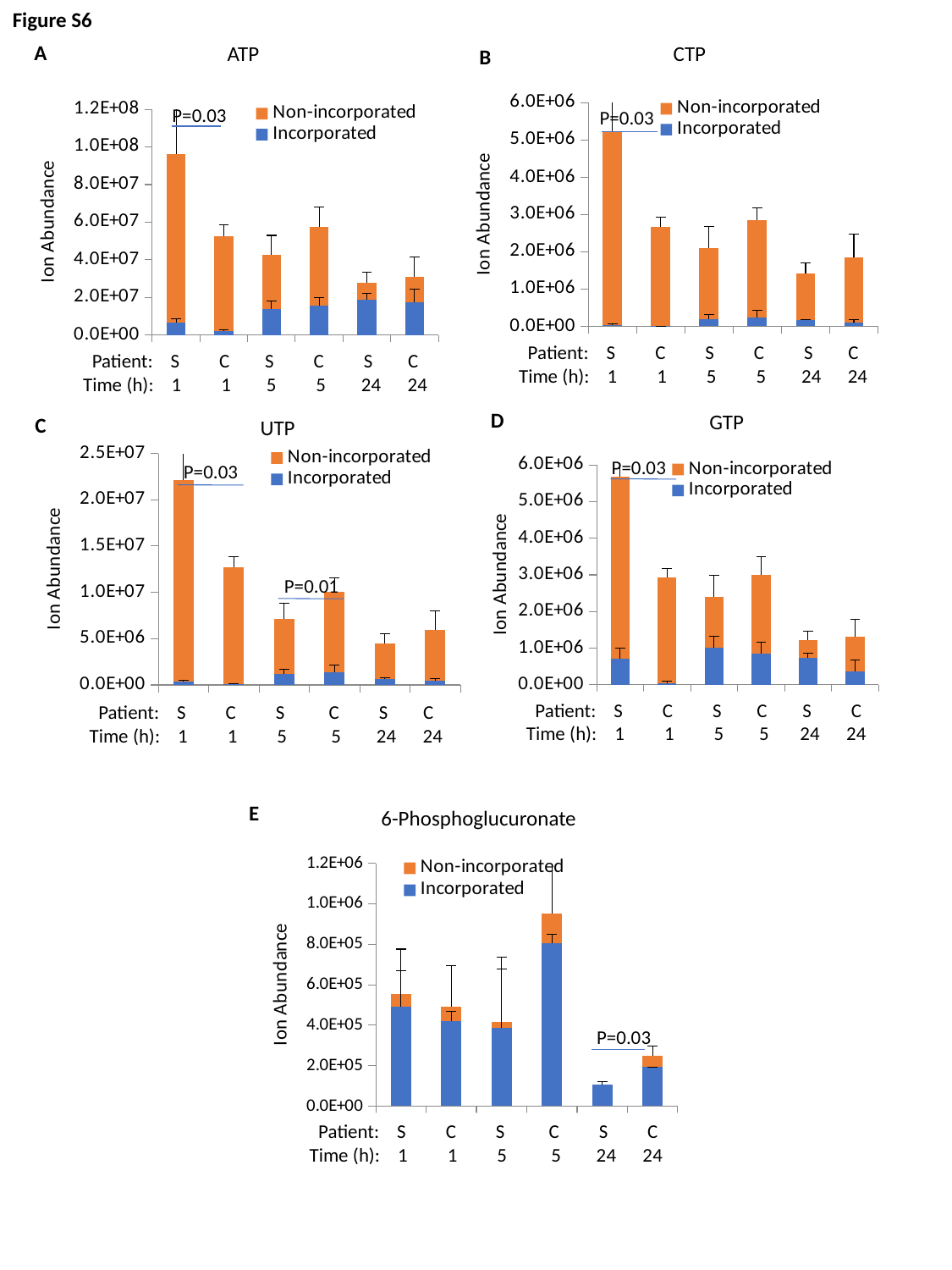
In the CTP chart, is the total value for patient S at 1 h greater or less than 4.0E+06? greater In the UTP chart, is the total value for patient C at 1 h greater or less than 1.0E+07? greater How many series does the legend of the CTP chart list? 2 In the 6-Phosphoglucuronate chart, is the total value for patient C at 5 h greater or less than 8.0E+05? greater In the GTP chart, which patient/time bar has the highest total ion abundance? S at 1 h In the UTP chart, which is larger, the total bar for patient S at 5 h or patient C at 5 h? C at 5 h In the 6-Phosphoglucuronate chart, which patient/time bar has the highest total ion abundance? C at 5 h What type of chart is the 6-Phosphoglucuronate chart? Stacked bar chart In the ATP chart, which patient/time bar has the highest total ion abundance? S at 1 h How many bars are plotted in the ATP chart? 6 In the CTP chart, which patient/time bar has the lowest total ion abundance? S at 24 h